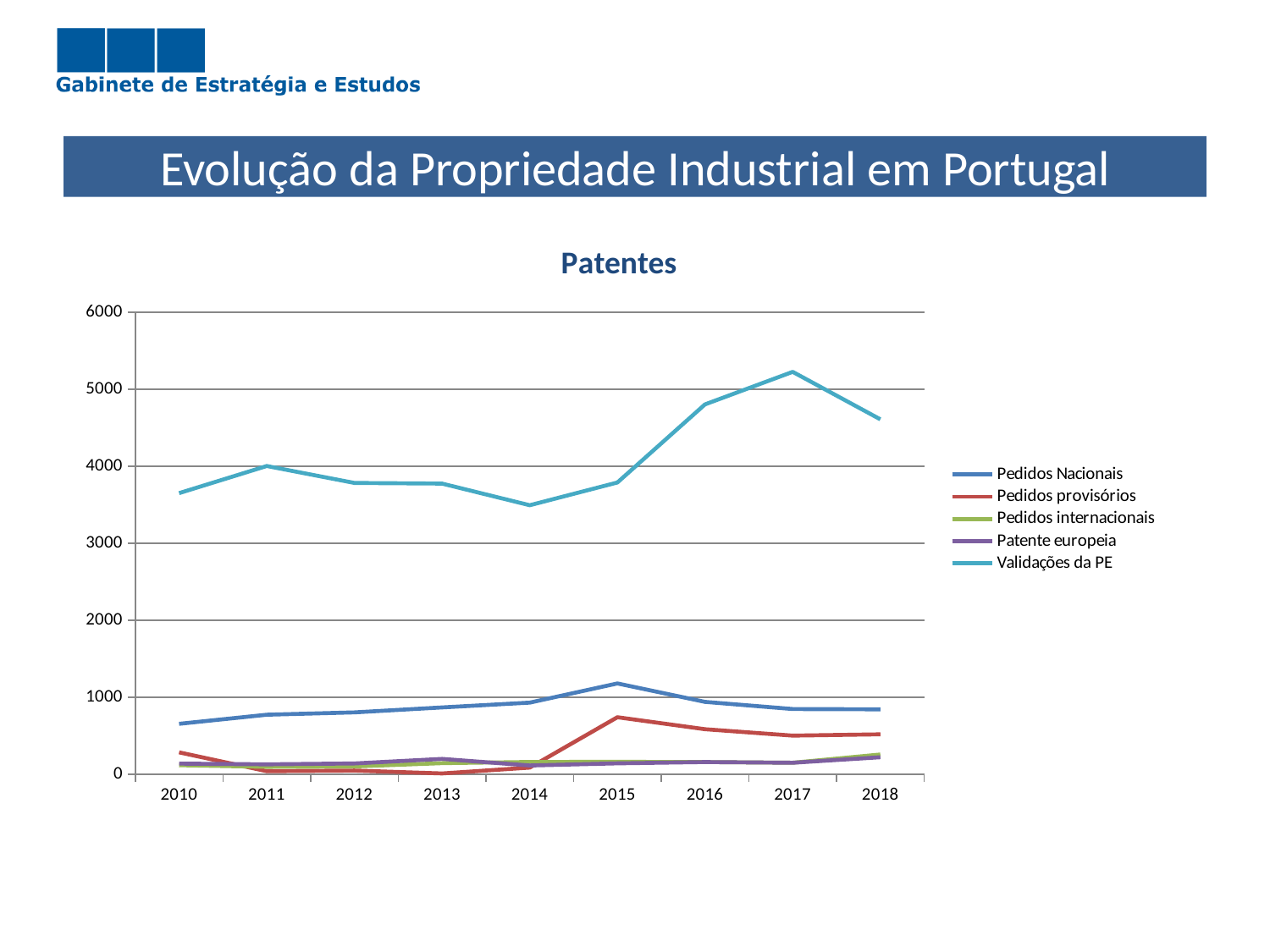
In which year does the Validações da PE series reach its highest value? 2017 Does the Validações da PE series rise or fall between 2014 and 2017? rise How many years are shown on the x axis of the Patentes chart? 9 In which year does the Pedidos Nacionais series reach its highest value? 2015 How many series does the legend of the Patentes chart list? 5 Is the value for Validações da PE in 2014 greater or less than 4000? less Is the value for Pedidos Nacionais in 2015 greater or less than 1000? greater Which series has the larger value in 2018, Validações da PE or Pedidos Nacionais? Validações da PE What kind of chart is shown on the slide? line chart What is the title of the chart on the slide? Patentes In which year does the Validações da PE series reach its lowest value? 2014 Is the value for Validações da PE in 2017 greater or less than 5000? greater